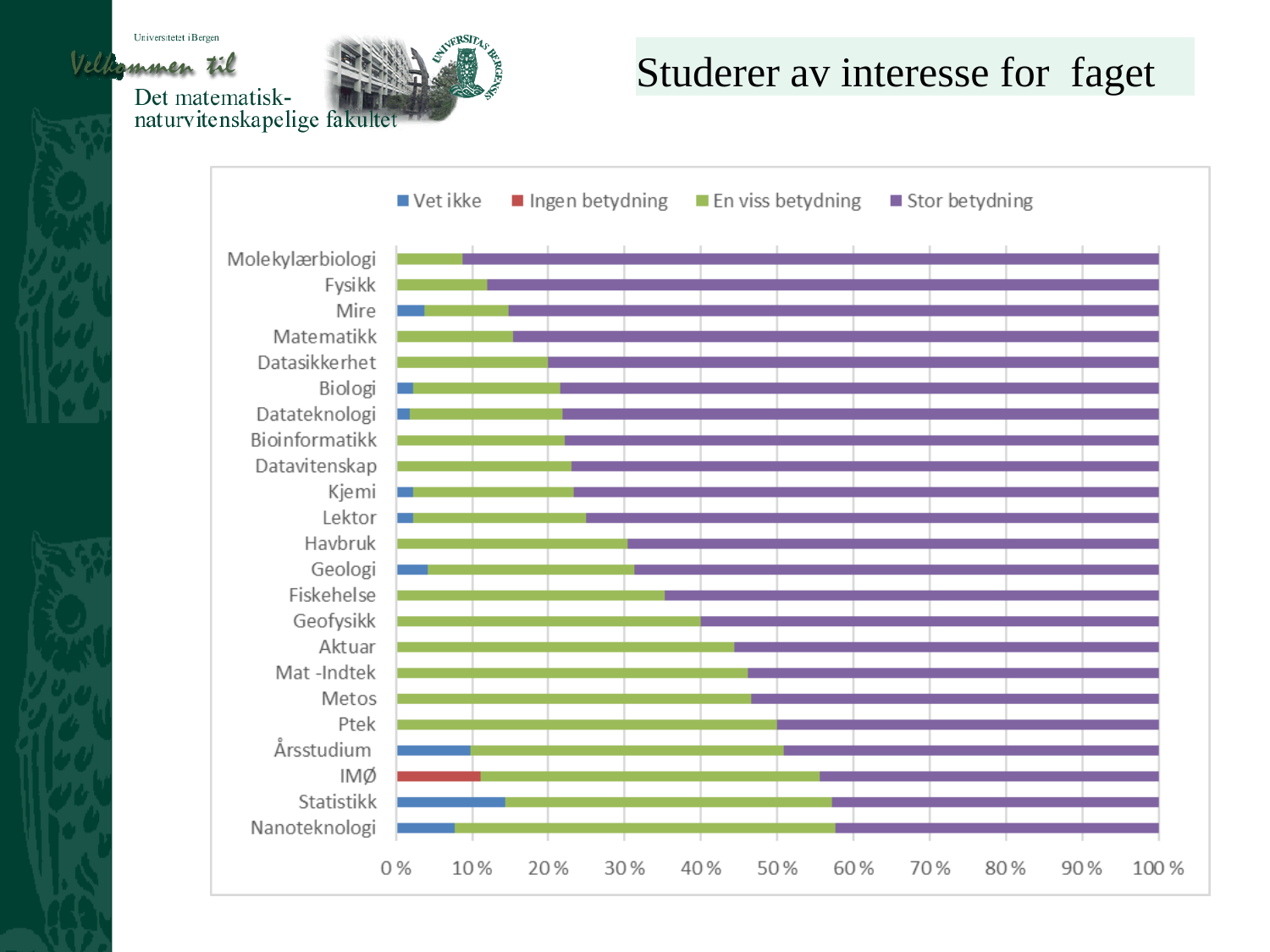
Is the 'Vet ikke' share for Statistikk greater or less than 10%? greater Which has the larger 'Vet ikke' share, Statistikk or Mire? Statistikk Is the 'Stor betydning' share for Nanoteknologi greater or less than 50%? less Which category is the only one with an 'Ingen betydning' (red) segment? IMØ How many series does the legend list? 4 Is the 'Stor betydning' share for Molekylærbiologi greater or less than 80%? greater What kind of chart is shown on the slide? Stacked bar chart Which category has the largest 'Stor betydning' share? Molekylærbiologi What is the total of the stacked bar for Fysikk? 100 % Which series is shown in purple in the legend? Stor betydning How many categories (study programmes) are shown on the vertical axis? 23